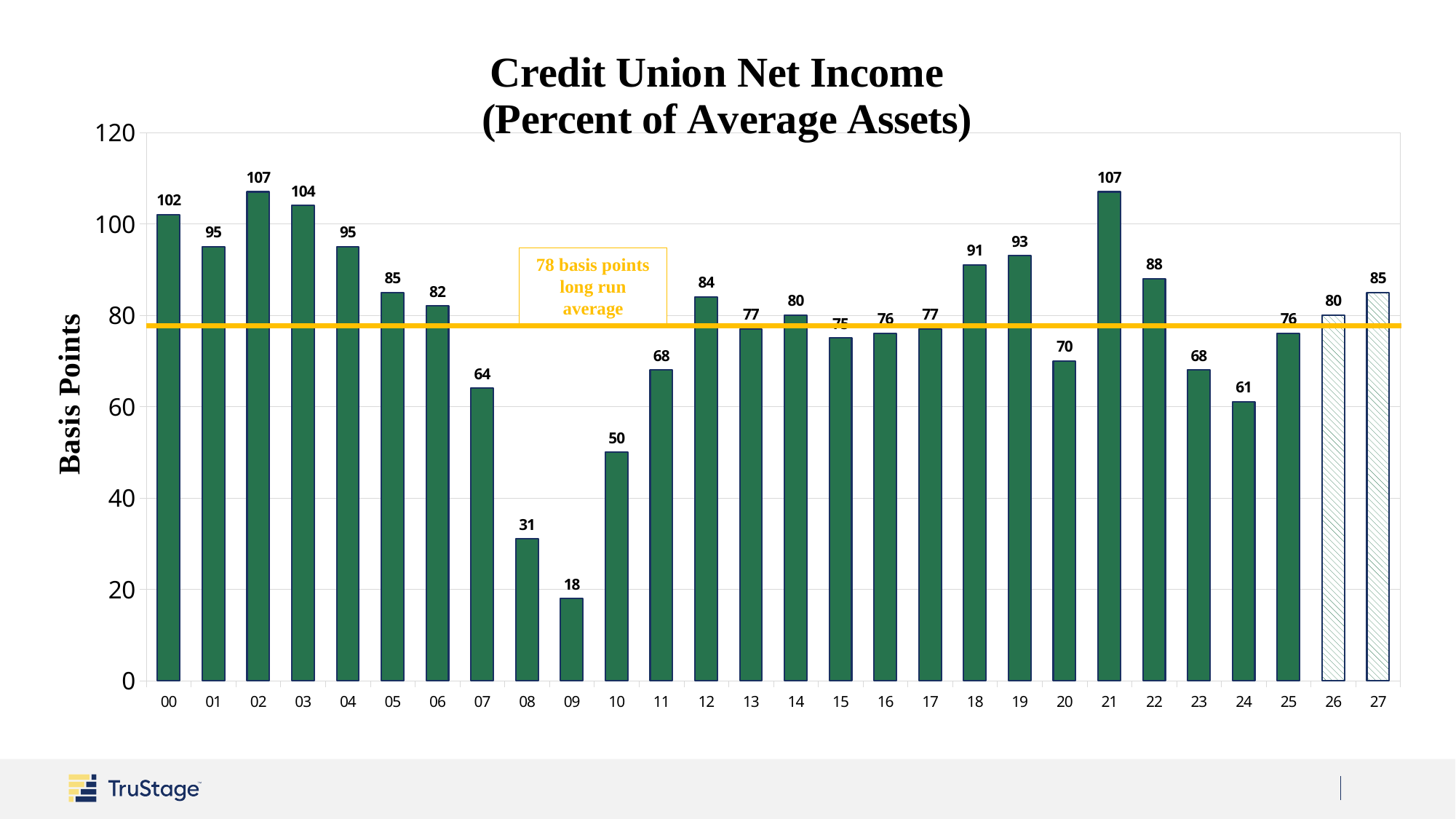
What is the value for 21? 107 Which is larger, the value for 18 or the value for 19? 19 What long run average does the horizontal line mark? 78 basis points What kind of chart is this? bar chart What is the value for 27? 85 What is the difference between the values for 08 and 09? 13 What is the value for 10? 50 Which year has the lowest value? 09 How many years are shown on the x axis? 28 What is the value for 09? 18 What is the highest value shown on the chart? 107 What is the difference between the values for 21 and 22? 19